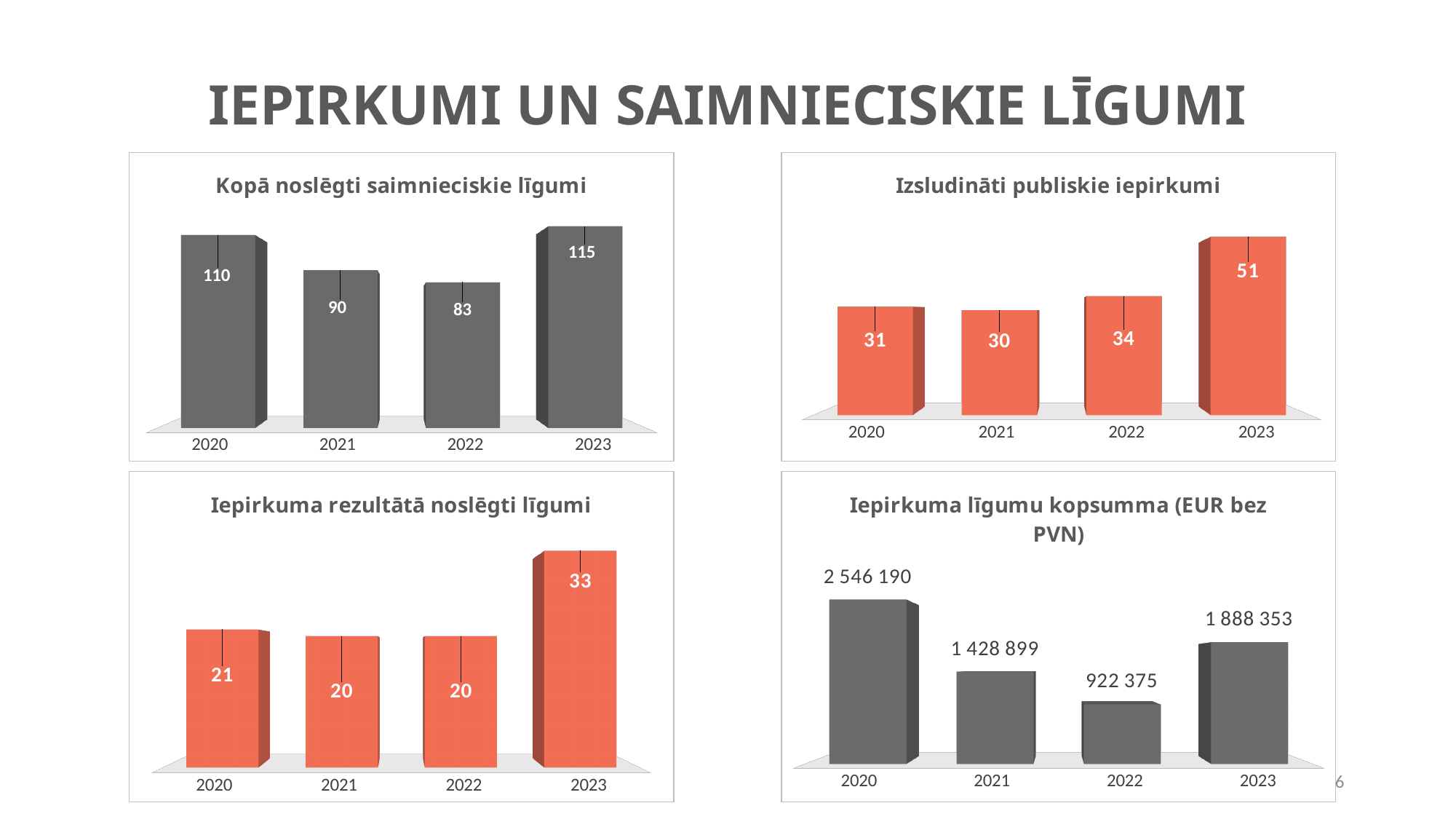
In the chart titled "Iepirkuma rezultātā noslēgti līgumi", what is the difference between the values for 2023 and 2022? 13 What kind of chart is the chart titled "Izsludināti publiskie iepirkumi"? Bar chart In the chart titled "Izsludināti publiskie iepirkumi", how many years are shown on the x axis? 4 In the chart titled "Kopā noslēgti saimnieciskie līgumi", which year has the highest value? 2023 In the chart titled "Iepirkuma līgumu kopsumma (EUR bez PVN)", what is the value for 2021? 1 428 899 In the chart titled "Izsludināti publiskie iepirkumi", which year has the lowest value? 2021 In the chart titled "Izsludināti publiskie iepirkumi", what is the value for 2023? 51 In the chart titled "Iepirkuma līgumu kopsumma (EUR bez PVN)", is the value for 2020 larger or the value for 2023? 2020 In the chart titled "Kopā noslēgti saimnieciskie līgumi", what is the difference between the values for 2020 and 2021? 20 In the chart titled "Iepirkuma līgumu kopsumma (EUR bez PVN)", which year has the lowest value? 2022 In the chart titled "Iepirkuma rezultātā noslēgti līgumi", what is the value for 2020? 21 In the chart titled "Kopā noslēgti saimnieciskie līgumi", what is the value for 2022? 83